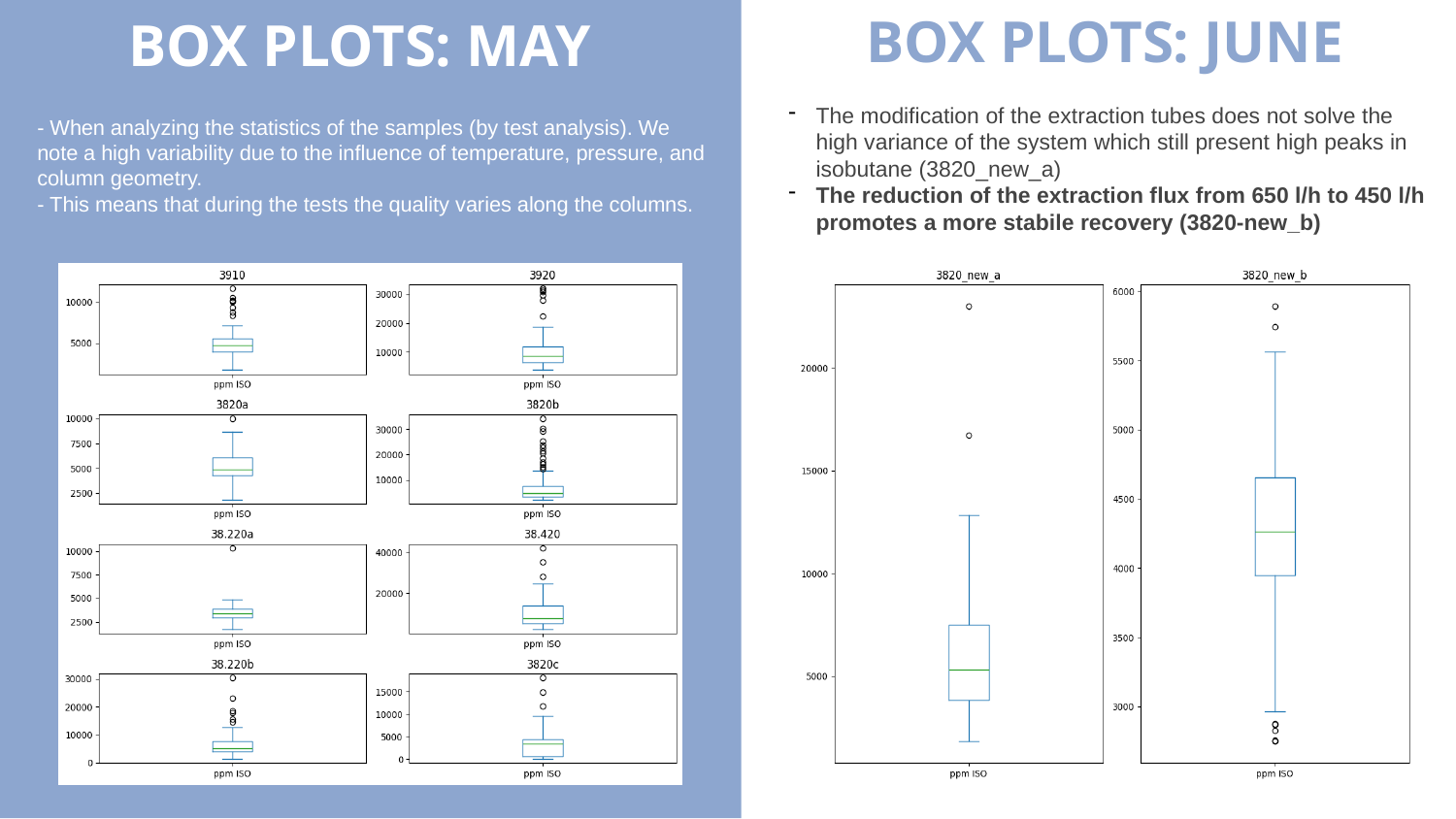
In the 'BOX PLOTS: JUNE' panel, what is the title of the left box plot? 3820_new_a In the 'BOX PLOTS: JUNE' panel, is the median of 3820_new_a greater or less than 10000? less How many individual box plots are shown in the 'BOX PLOTS: MAY' panel on the left? 8 In the 'BOX PLOTS: MAY' panel, is the median of 3910 greater or less than 10000? less In the 'BOX PLOTS: JUNE' panel, is the median of 3820_new_b greater or less than 4000? greater What kind of chart is shown on the right-hand side of the slide under 'BOX PLOTS: JUNE'? Box plot How many box plots are shown in the 'BOX PLOTS: JUNE' panel on the right? 2 In the 'BOX PLOTS: JUNE' panel, what label appears on the x axis of each box plot? ppm ISO